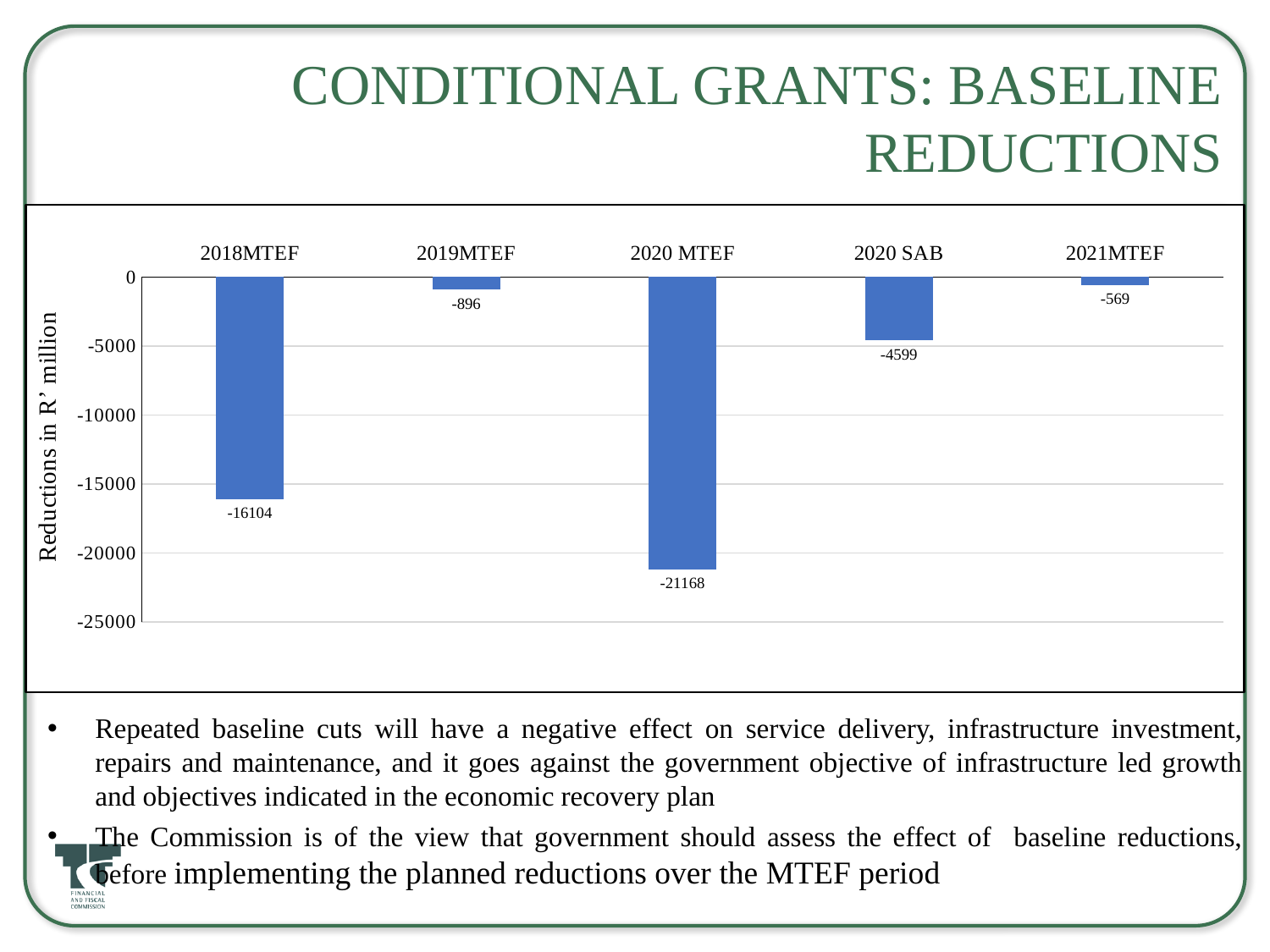
Which category has the lowest value? 2020 MTEF What is the difference between the values for 2020 MTEF and 2018MTEF? 5064 What is the value for 2021MTEF? -569 What is the value for 2018MTEF? -16104 What is the label on the vertical axis of the chart? Reductions in R' million Which value is larger, 2019MTEF or 2021MTEF? 2021MTEF Which category has the highest value? 2021MTEF How many categories are shown on the x axis? 5 What is the value for 2020 SAB? -4599 What is the difference between the values for 2019MTEF and 2021MTEF? 327 What is the value for 2020 MTEF? -21168 What kind of chart is shown on the slide? Bar chart